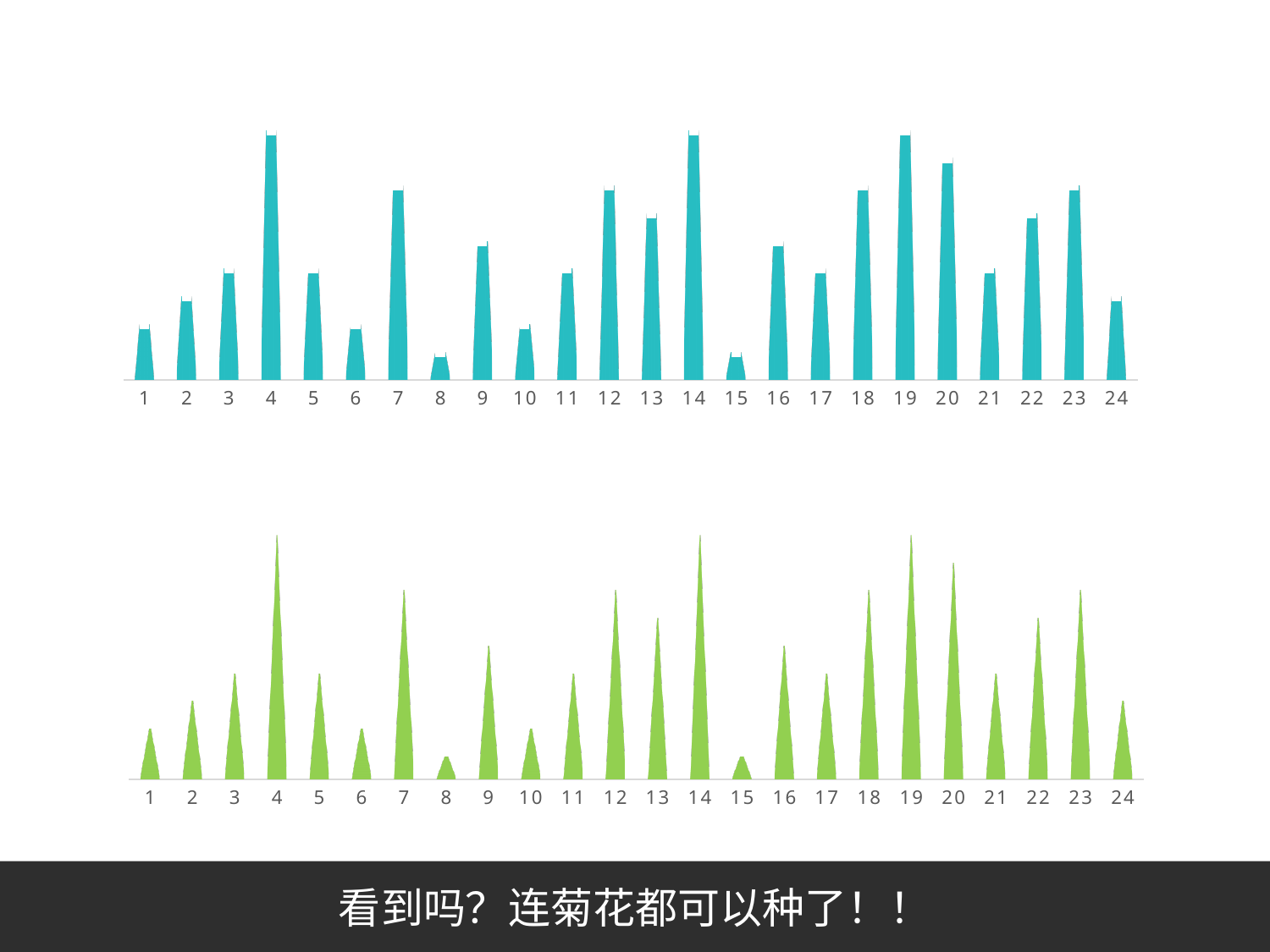
In the top chart, which is larger, the value for category 4 or the value for category 1? category 4 In the bottom chart, which is larger, the value for category 2 or the value for category 3? category 3 In the top chart, which is larger, the value for category 20 or the value for category 21? category 20 What kind of chart is the top chart? bar chart How many categories are shown on the x axis of the bottom chart? 24 How many categories are shown on the x axis of the top chart? 24 What colour are the bars in the top chart? teal What colour are the bars in the bottom chart? green